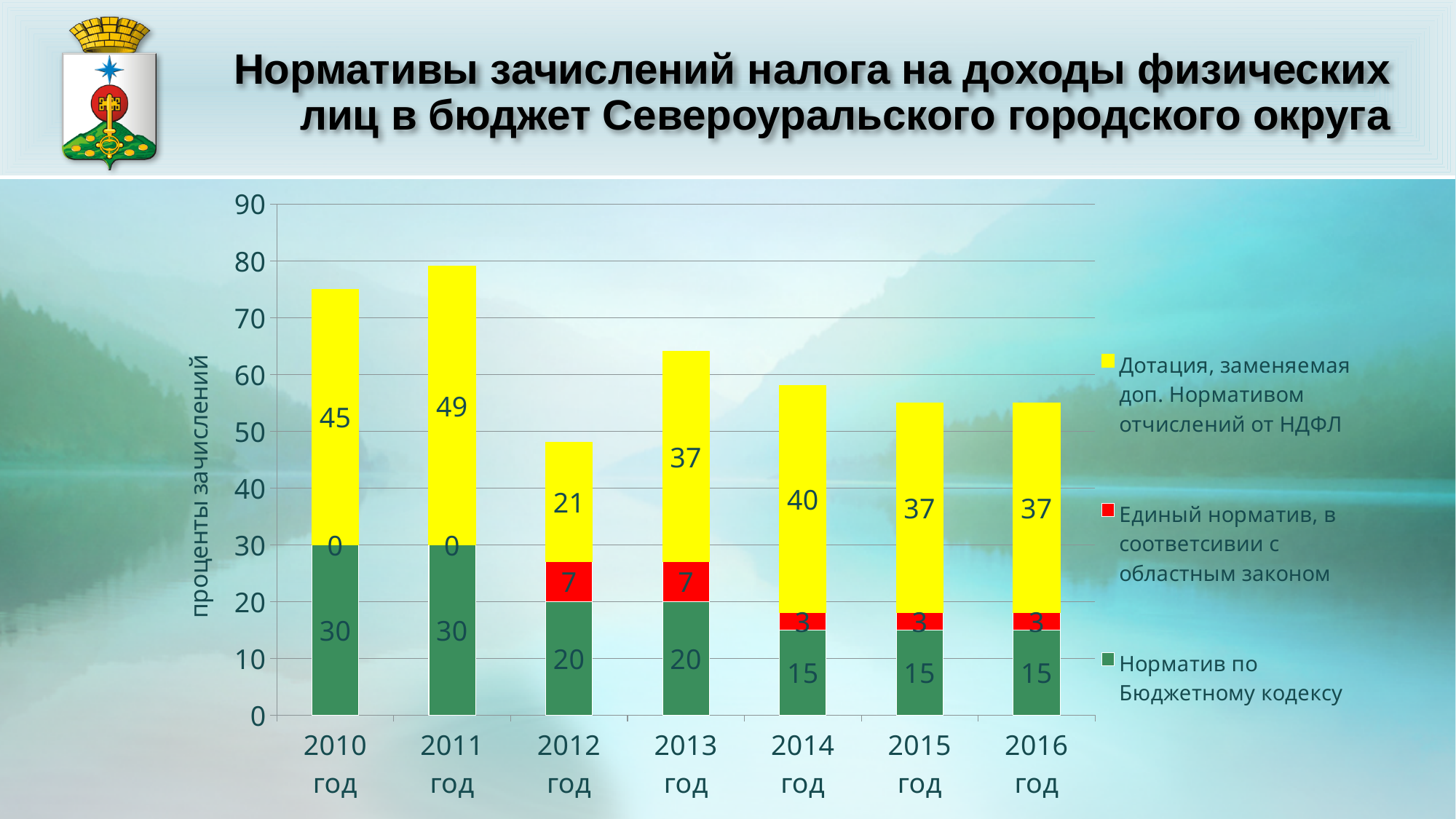
What is the label of the y axis? проценты зачислений In which year is the 'Дотация, заменяемая доп. Нормативом отчислений от НДФЛ' value highest? 2011 год What is the value of 'Дотация, заменяемая доп. Нормативом отчислений от НДФЛ' for 2011 год? 49 Which is larger: the 'Дотация' value for 2013 год or for 2014 год? 2014 год How many series does the legend list? 3 In which year is the 'Дотация, заменяемая доп. Нормативом отчислений от НДФЛ' value lowest? 2012 год What type of chart is shown on the slide? stacked bar chart What is the value of 'Единый норматив, в соответсивии с областным законом' for 2012 год? 7 How many years are shown on the x axis? 7 What is the difference between the 'Норматив по Бюджетному кодексу' values for 2010 год and 2016 год? 15 What is the total of the stacked bar for 2013 год? 64 What is the value of 'Норматив по Бюджетному кодексу' for 2014 год? 15